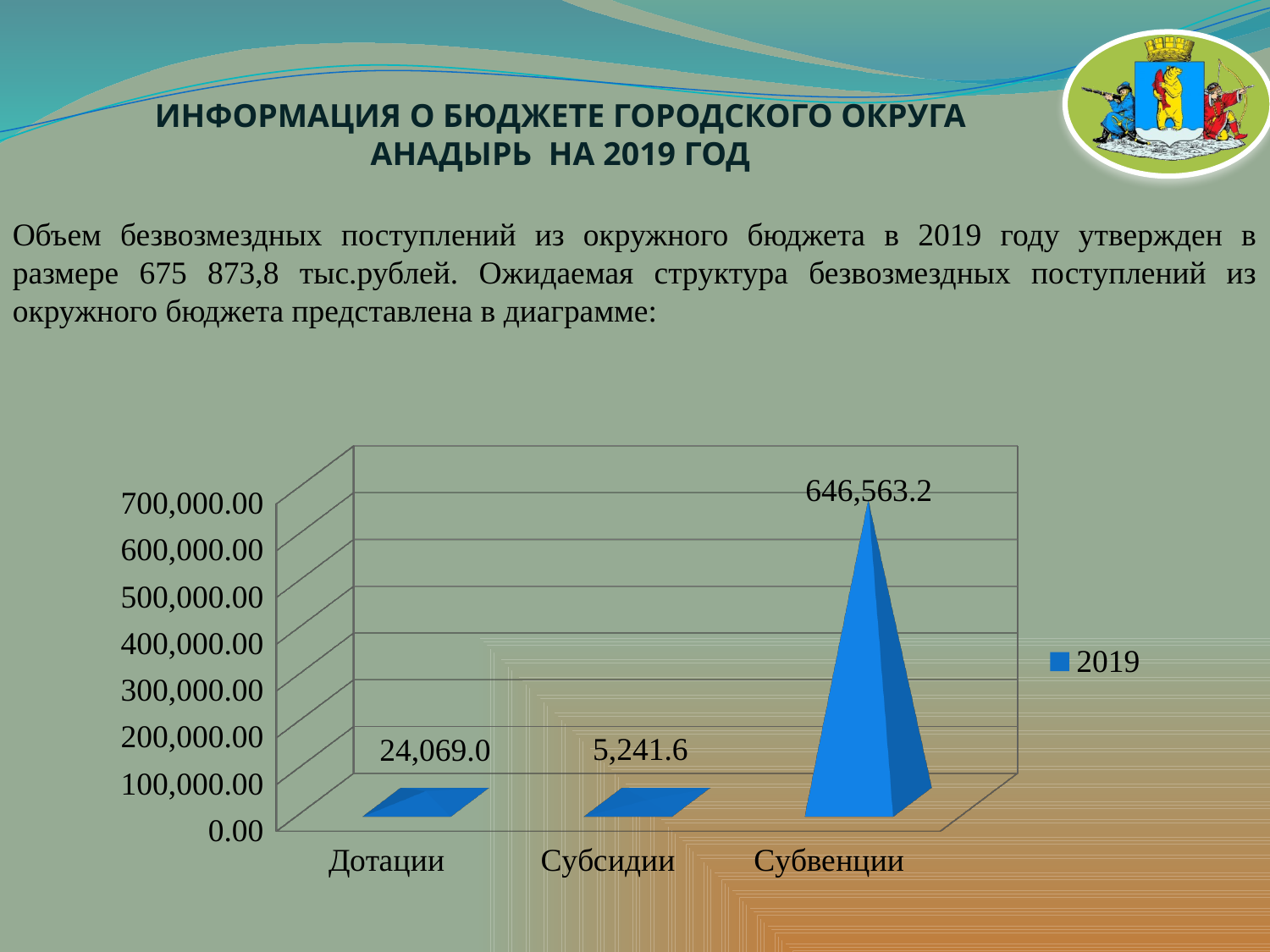
What kind of chart is shown on the slide? bar chart Is the value for Субвенции greater or less than 600,000.00? greater Which category has the lowest value in the chart? Субсидии Which is larger, the value for Дотации or the value for Субсидии? Дотации What is the difference between the values for Дотации and Субсидии? 18,827.4 What is the value for Дотации in the chart? 24,069.0 What is the value for Субвенции in the chart? 646,563.2 What is the value for Субсидии in the chart? 5,241.6 How many series does the chart legend list? 1 What is the difference between the values for Субвенции and Дотации? 622,494.2 Which category has the highest value in the chart? Субвенции How many categories are shown on the x axis of the chart? 3